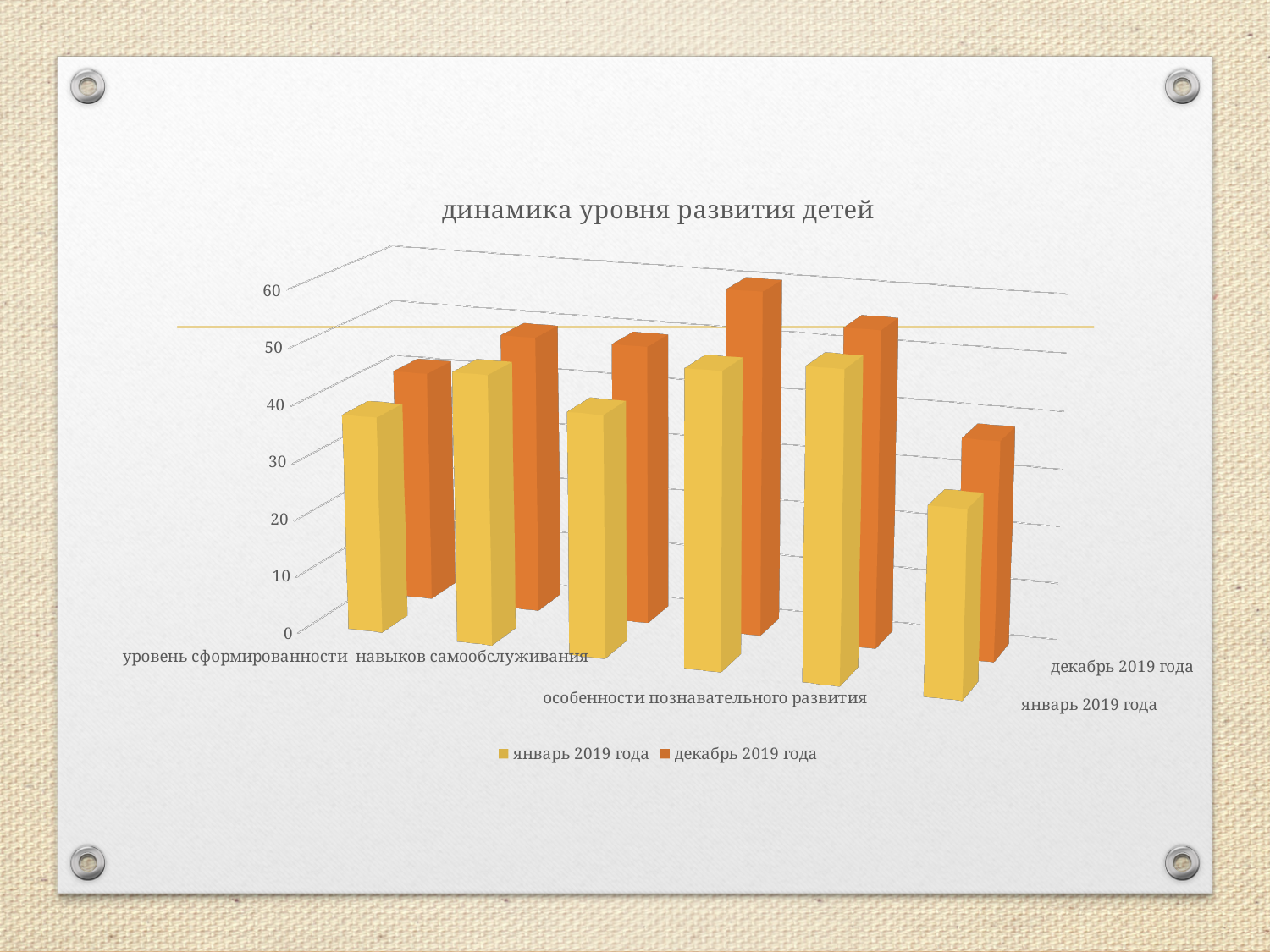
Which group of bars has the tallest декабрь 2019 года bar? the fourth group from the left Is the декабрь 2019 года bar taller than the январь 2019 года bar in every group? yes How many groups of bars (categories) are plotted in the chart? 6 In the leftmost group of bars, which series has the taller bar: январь 2019 года or декабрь 2019 года? декабрь 2019 года How many series does the legend list? 2 What is the title of the chart? динамика уровня развития детей Which group of bars has the shortest январь 2019 года bar? the rightmost (sixth) group What kind of chart is shown on the slide? bar chart What are the two series named in the legend? январь 2019 года and декабрь 2019 года In the rightmost group of bars, which series has the taller bar: январь 2019 года or декабрь 2019 года? декабрь 2019 года Which group of bars has the shortest декабрь 2019 года bar? the rightmost (sixth) group